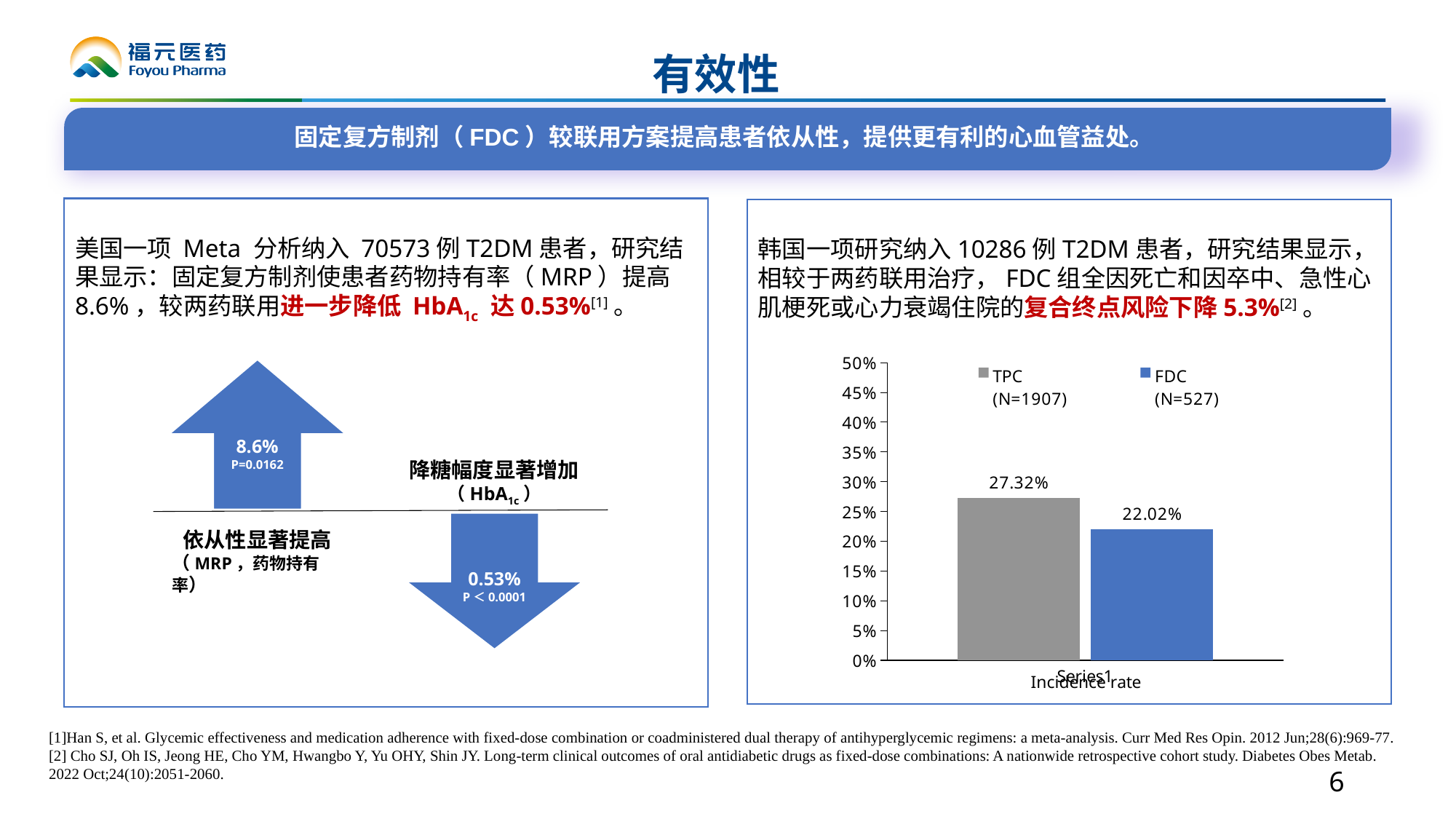
In the bar chart on the right, is the value for FDC greater or less than 25%? less In the bar chart on the right, what is the difference between the TPC and FDC incidence rates? 5.30% How many series does the legend of the bar chart on the right list? 2 In the bar chart on the right, which group has the lower incidence rate? FDC In the bar chart on the right, what is the incidence rate for FDC? 22.02% In the bar chart on the right, is the value for TPC greater or less than 25%? greater In the bar chart on the right, what is the incidence rate for TPC? 27.32% In the bar chart on the right, what sample size (N) is shown in the legend for the TPC group? N=1907 In the bar chart on the right, is the incidence rate for TPC larger or smaller than that for FDC? larger What kind of chart is shown on the right side of the slide? bar chart In the bar chart on the right, what colour is the FDC bar? blue In the bar chart on the right, which group has the higher incidence rate? TPC